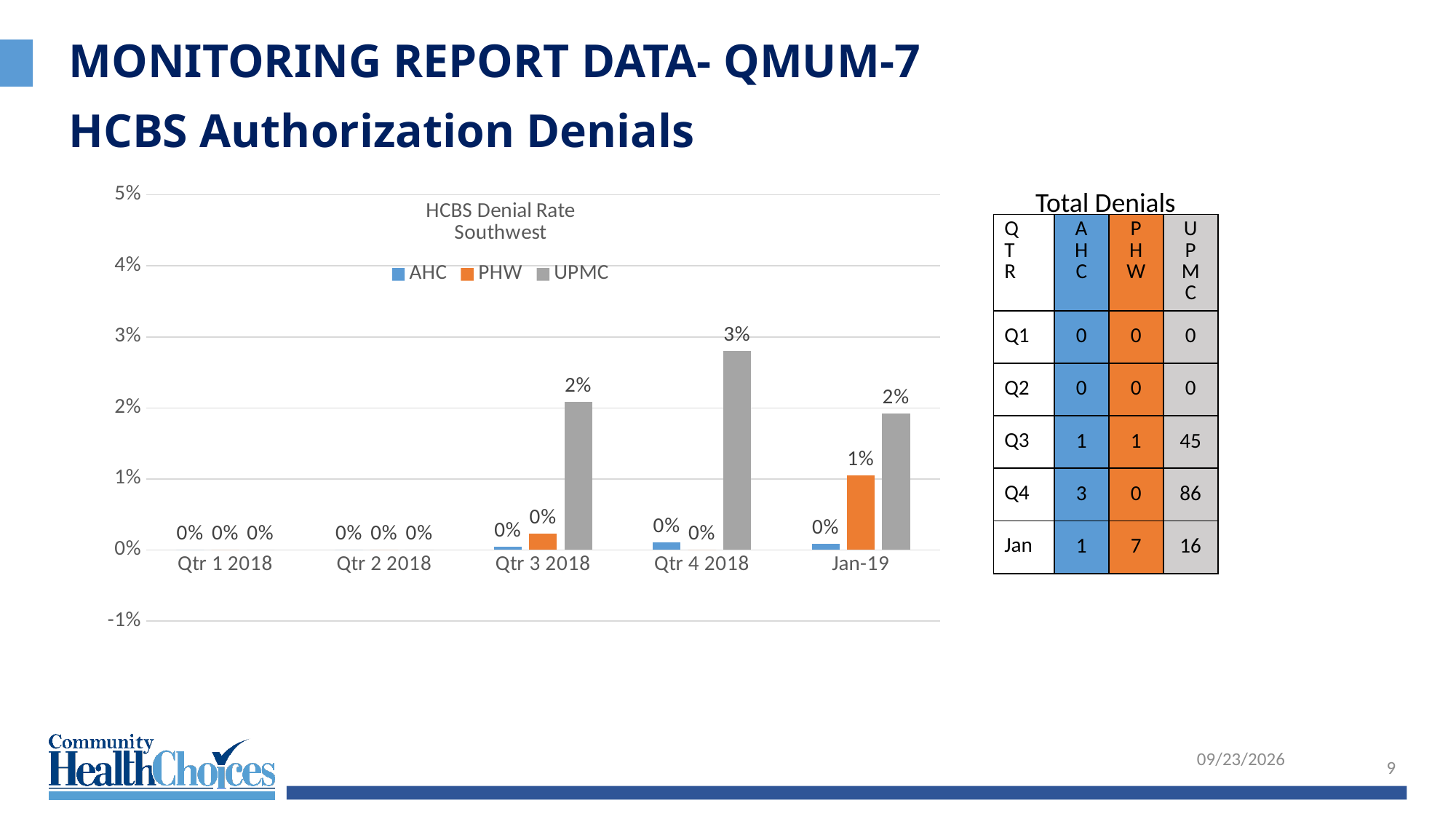
In the HCBS Denial Rate Southwest chart, which is larger for Jan-19: the UPMC value or the PHW value? UPMC What is the difference between the UPMC denial rate for Qtr 4 2018 and for Qtr 3 2018 in the HCBS Denial Rate Southwest chart? 1% What is the UPMC denial rate for Qtr 3 2018 in the HCBS Denial Rate Southwest chart? 2% How many series does the legend of the HCBS Denial Rate Southwest chart list? 3 What is the UPMC denial rate for Qtr 4 2018 in the HCBS Denial Rate Southwest chart? 3% What are the legend entries of the HCBS Denial Rate Southwest chart? AHC, PHW, UPMC Does the UPMC denial rate rise or fall from Qtr 1 2018 to Qtr 4 2018 in the HCBS Denial Rate Southwest chart? rise In which period does UPMC have its highest denial rate in the HCBS Denial Rate Southwest chart? Qtr 4 2018 What is the PHW denial rate for Jan-19 in the HCBS Denial Rate Southwest chart? 1% What kind of chart is the HCBS Denial Rate Southwest chart? bar chart Is the UPMC value for Qtr 4 2018 in the HCBS Denial Rate Southwest chart greater or less than 2%? greater How many categories are shown on the x axis of the HCBS Denial Rate Southwest chart? 5